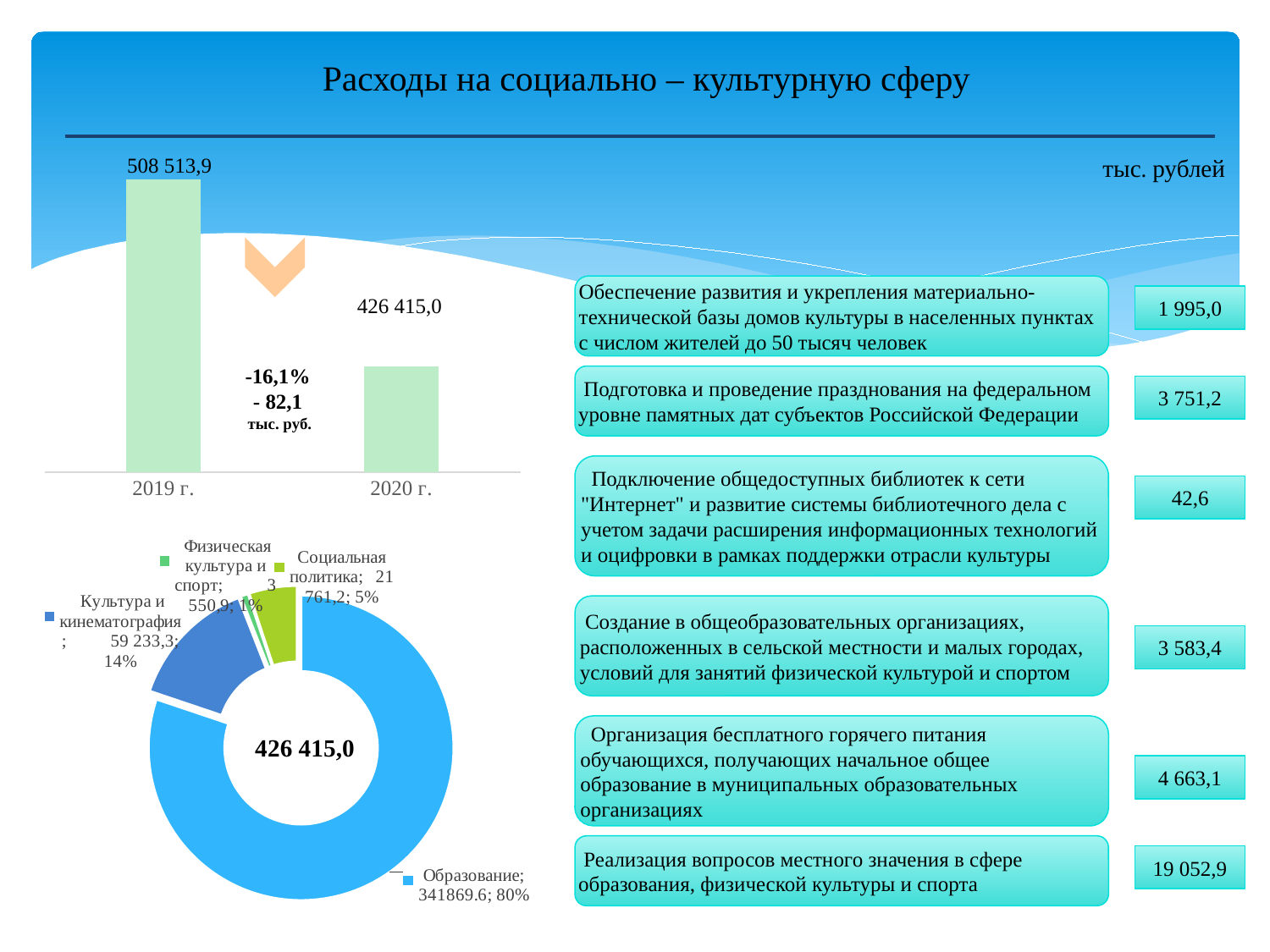
In the donut chart, what is the value for Социальная политика? 21 761,2 In the bar chart, do the values rise or fall from 2019 г. to 2020 г.? fall In the bar chart, what is the difference between the 2019 г. and 2020 г. values? 82 098,9 In the bar chart, which year has the higher value, 2019 г. or 2020 г.? 2019 г. In the bar chart, what is the value for 2019 г.? 508 513,9 What kind of chart is the chart at the bottom left of the slide? pie chart (donut) In the donut chart, what share does Образование have? 80% How many categories does the donut chart show? 4 In the donut chart, which category has the smallest share? Физическая культура и спорт In the donut chart, what is the value for Культура и кинематография? 59 233,3 In the bar chart, what percentage change is shown between 2019 г. and 2020 г.? -16,1% In the bar chart, what is the value for 2020 г.? 426 415,0